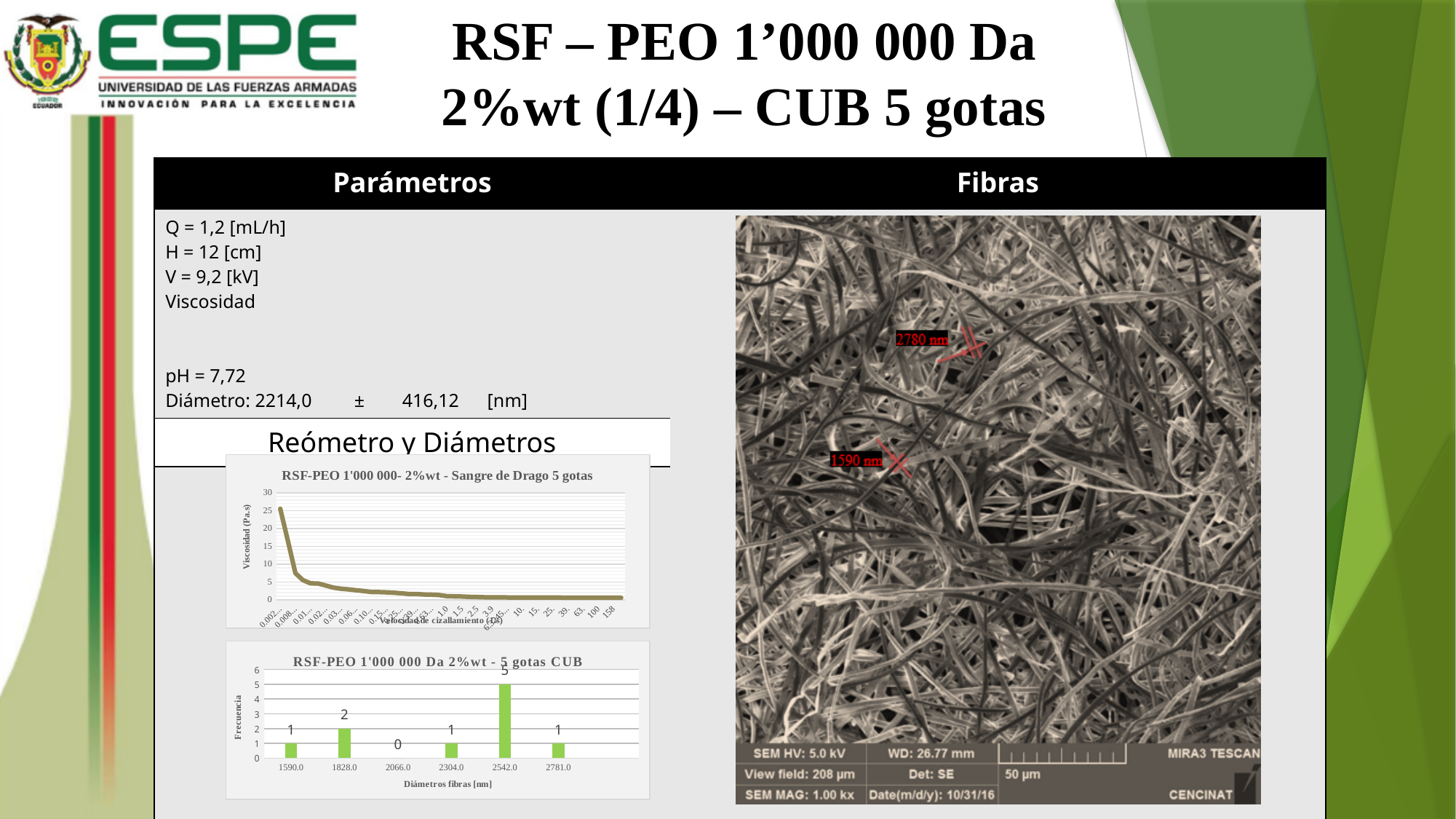
In the top chart titled "RSF-PEO 1'000 000- 2%wt - Sangre de Drago 5 gotas", is the viscosity at the first x-axis point (0.002) greater or less than 20? greater In the bottom chart titled "RSF-PEO 1'000 000 Da 2%wt - 5 gotas CUB", what is the frequency for the 2542.0 nm diameter? 5 In the bottom chart titled "RSF-PEO 1'000 000 Da 2%wt - 5 gotas CUB", how many diameter categories are shown on the x axis? 6 In the bottom chart titled "RSF-PEO 1'000 000 Da 2%wt - 5 gotas CUB", which has a higher frequency, 1828.0 or 2304.0? 1828.0 In the bottom chart titled "RSF-PEO 1'000 000 Da 2%wt - 5 gotas CUB", what is the total of all the frequencies shown? 10 In the bottom chart titled "RSF-PEO 1'000 000 Da 2%wt - 5 gotas CUB", what is the difference between the frequency at 2542.0 and the frequency at 1828.0? 3 In the top chart titled "RSF-PEO 1'000 000- 2%wt - Sangre de Drago 5 gotas", does the viscosity rise or fall as the shear rate increases along the x axis? fall What kind of chart is the bottom chart titled "RSF-PEO 1'000 000 Da 2%wt - 5 gotas CUB"? bar chart In the bottom chart titled "RSF-PEO 1'000 000 Da 2%wt - 5 gotas CUB", which diameter category has the lowest frequency? 2066.0 What kind of chart is the top chart titled "RSF-PEO 1'000 000- 2%wt - Sangre de Drago 5 gotas"? line chart In the bottom chart titled "RSF-PEO 1'000 000 Da 2%wt - 5 gotas CUB", which diameter category has the highest frequency? 2542.0 In the bottom chart titled "RSF-PEO 1'000 000 Da 2%wt - 5 gotas CUB", what is the frequency for the 1828.0 nm diameter? 2